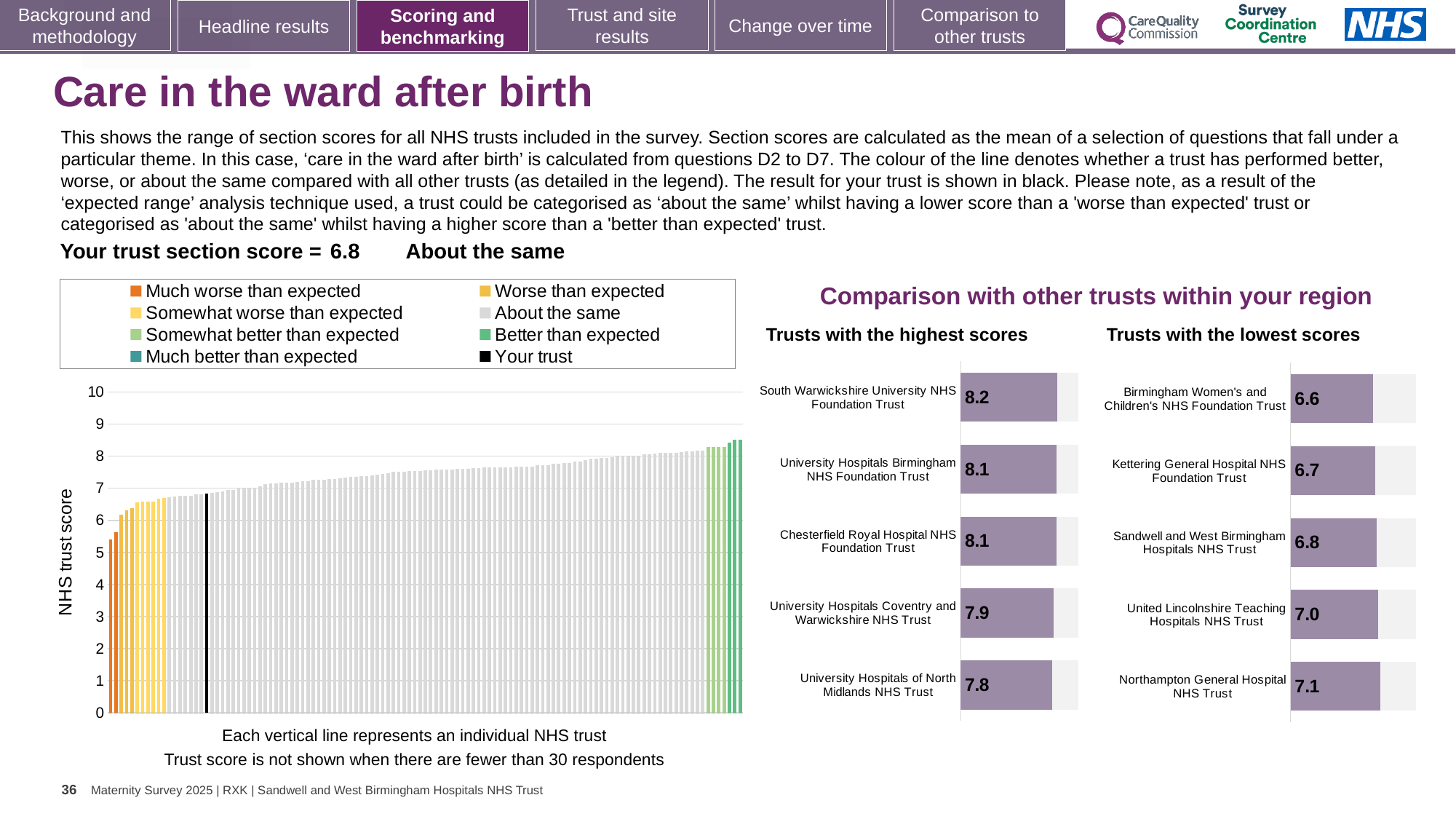
In the 'Trusts with the highest scores' chart, what is the difference between the scores of South Warwickshire University NHS Foundation Trust and University Hospitals of North Midlands NHS Trust? 0.4 In the 'Trusts with the highest scores' chart, which trust has the highest score? South Warwickshire University NHS Foundation Trust In the 'Trusts with the lowest scores' chart, which trust has the lowest score? Birmingham Women's and Children's NHS Foundation Trust In the 'NHS trust score' chart on the left, is the value of the black bar (your trust) greater or less than 5? greater In the 'Trusts with the lowest scores' chart, which has the larger score: United Lincolnshire Teaching Hospitals NHS Trust or Sandwell and West Birmingham Hospitals NHS Trust? United Lincolnshire Teaching Hospitals NHS Trust In the 'NHS trust score' chart on the left, do the values rise or fall from left to right? rise How many entries does the legend of the 'NHS trust score' chart on the left list? 8 What kind of chart is the large 'NHS trust score' chart on the left of the slide? bar chart In the 'Trusts with the highest scores' chart, how many trusts are shown? 5 In the 'Trusts with the lowest scores' chart, what is the score for Kettering General Hospital NHS Foundation Trust? 6.7 In the 'Trusts with the highest scores' chart, what is the score for South Warwickshire University NHS Foundation Trust? 8.2 In the 'Trusts with the lowest scores' chart, what is the difference between the scores of Northampton General Hospital NHS Trust and Birmingham Women's and Children's NHS Foundation Trust? 0.5